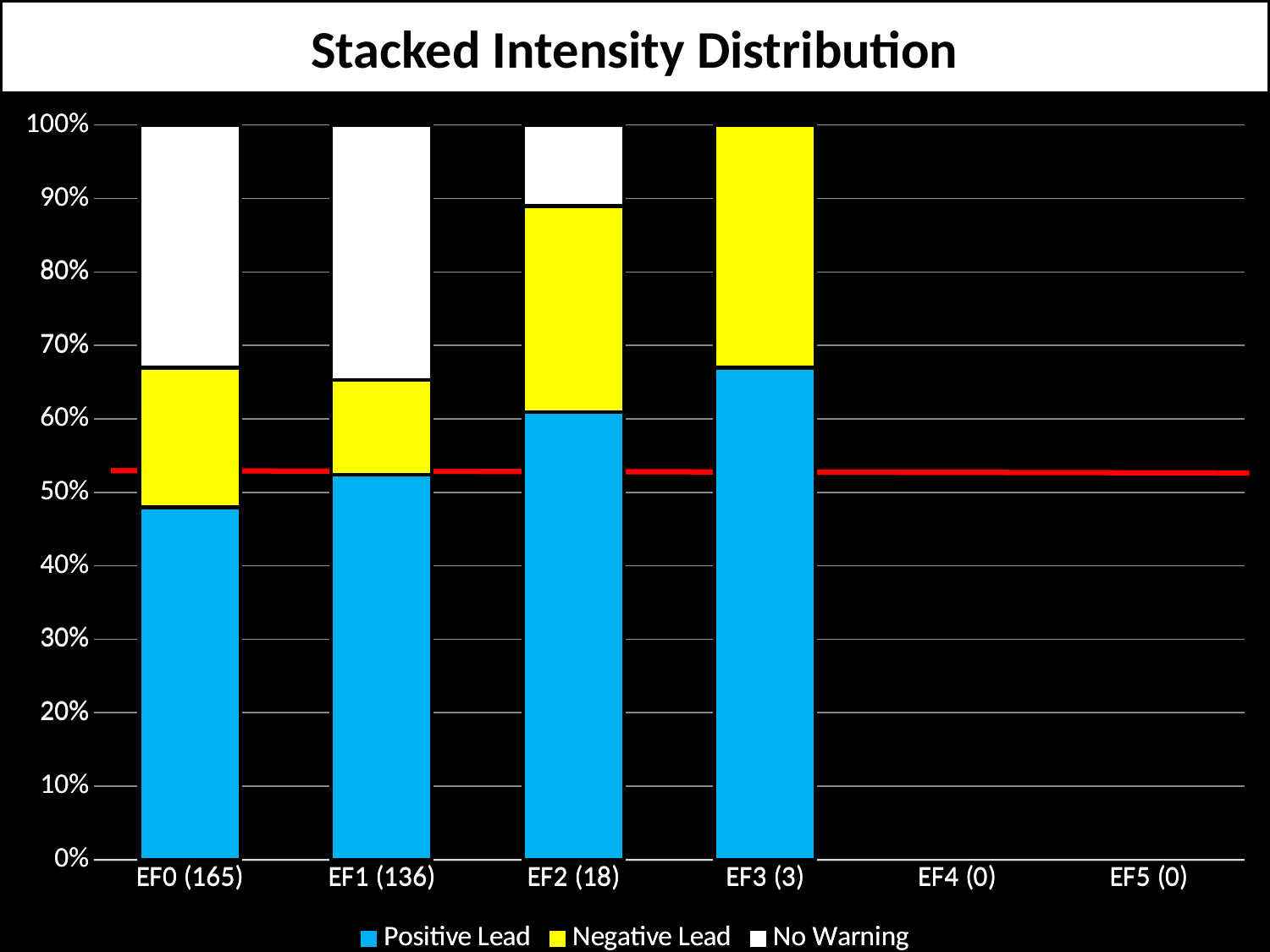
Does the Positive Lead share rise or fall from EF0 (165) to EF3 (3)? rise How many series does the legend list? 3 Is the Positive Lead share for EF3 (3) greater or less than 60%? greater Which category has the smallest Positive Lead share among the bars plotted? EF0 (165) Is the No Warning share for EF2 (18) greater or less than 20%? less Which category has the largest Positive Lead share? EF3 (3) Is the Positive Lead share for EF0 (165) greater or less than 50%? less How many categories are shown on the x axis? 6 What kind of chart is shown on the slide? Stacked bar chart What is the title of the chart? Stacked Intensity Distribution Which has a larger Positive Lead share, EF0 (165) or EF3 (3)? EF3 (3) What colour represents the Negative Lead series? Yellow